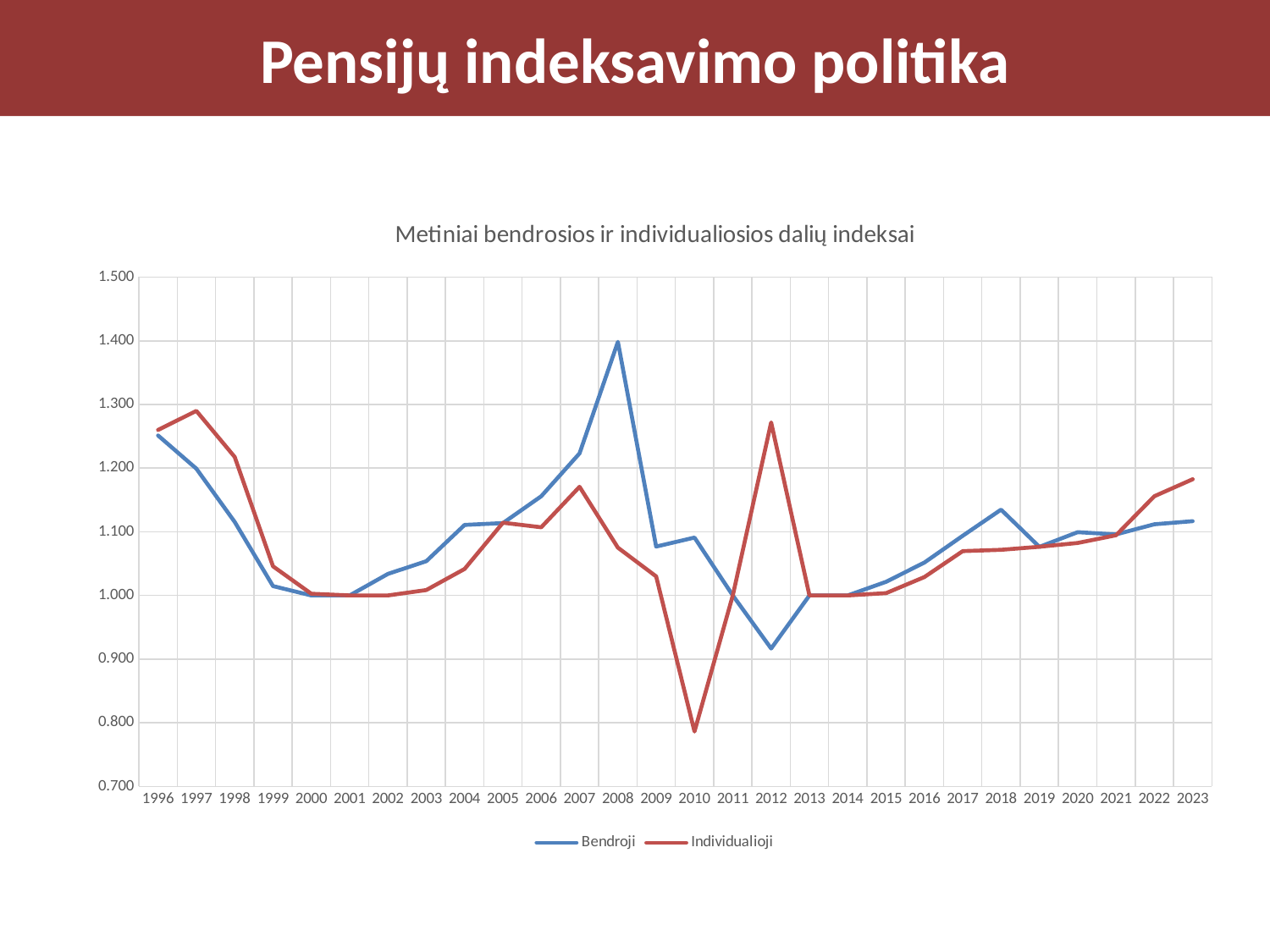
What is the title of the chart? Metiniai bendrosios ir individualiosios dalių indeksai Does the Bendroji series rise or fall from 1996 to 2000? Fall In which year does the Individualioji series reach its lowest value? 2010 Is the Bendroji value for 2008 greater or less than 1.300? greater In which year does the Bendroji series reach its lowest value? 2012 What kind of chart is shown on the slide? Line chart How many series does the legend list? 2 In 2012, which series has the larger value, Bendroji or Individualioji? Individualioji Which series is drawn in red? Individualioji Is the Individualioji value for 2010 greater or less than 0.900? less How many years are plotted along the x axis? 28 In which year does the Bendroji series reach its highest value? 2008